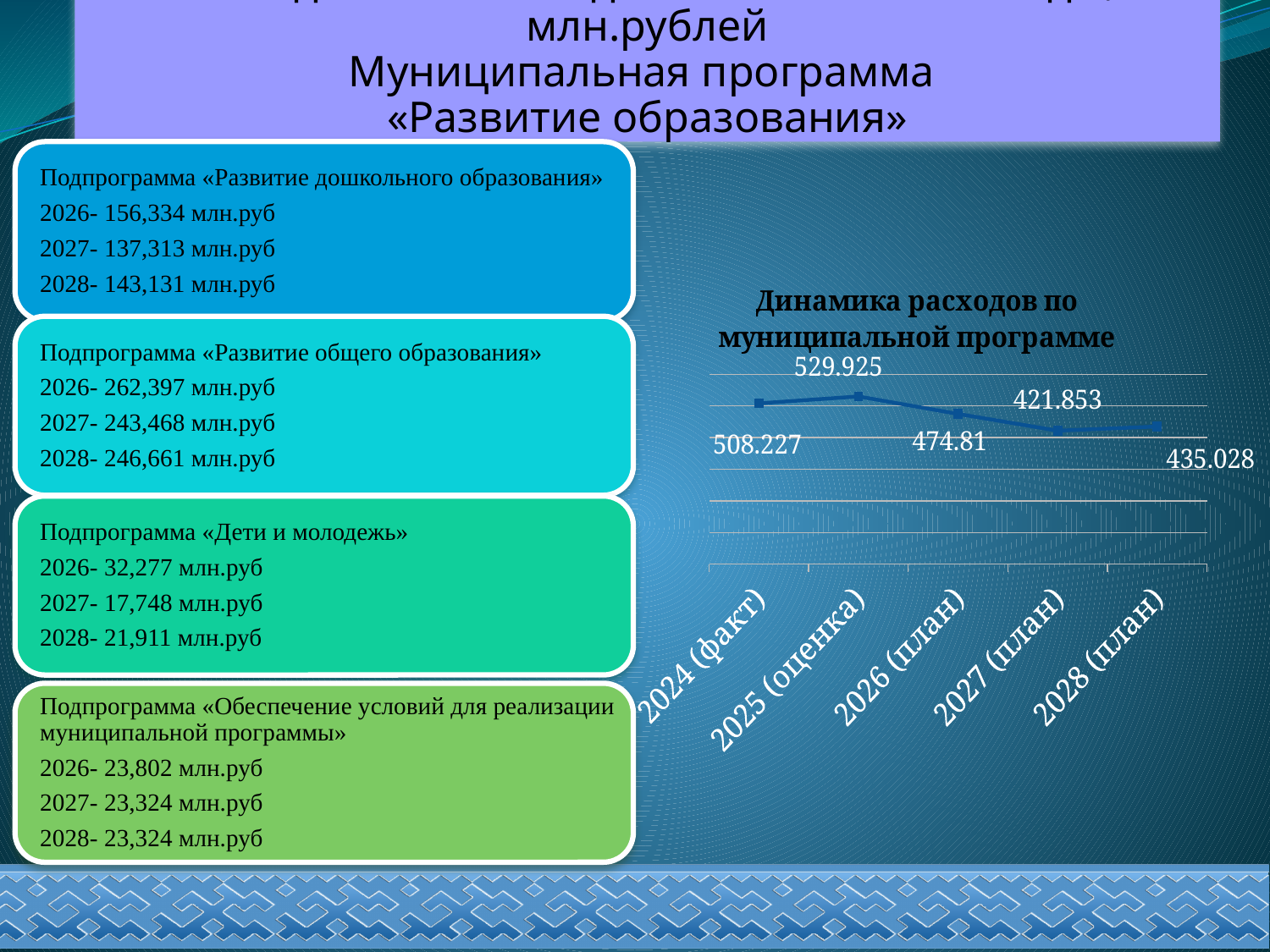
What is the title of the chart? Динамика расходов по муниципальной программе Which year has the lowest value on the chart? 2027 (план) What is the difference between the values for 2025 (оценка) and 2026 (план)? 55.115 What is the value for 2024 (факт)? 508.227 Which is larger, the value for 2024 (факт) or the value for 2028 (план)? 2024 (факт) Which year has the highest value on the chart? 2025 (оценка) What is the value for 2027 (план)? 421.853 How many data points are plotted on the chart? 5 What type of chart is shown on the slide? line chart What is the value for 2025 (оценка)? 529.925 What is the value for 2028 (план)? 435.028 What is the value for 2026 (план)? 474.81